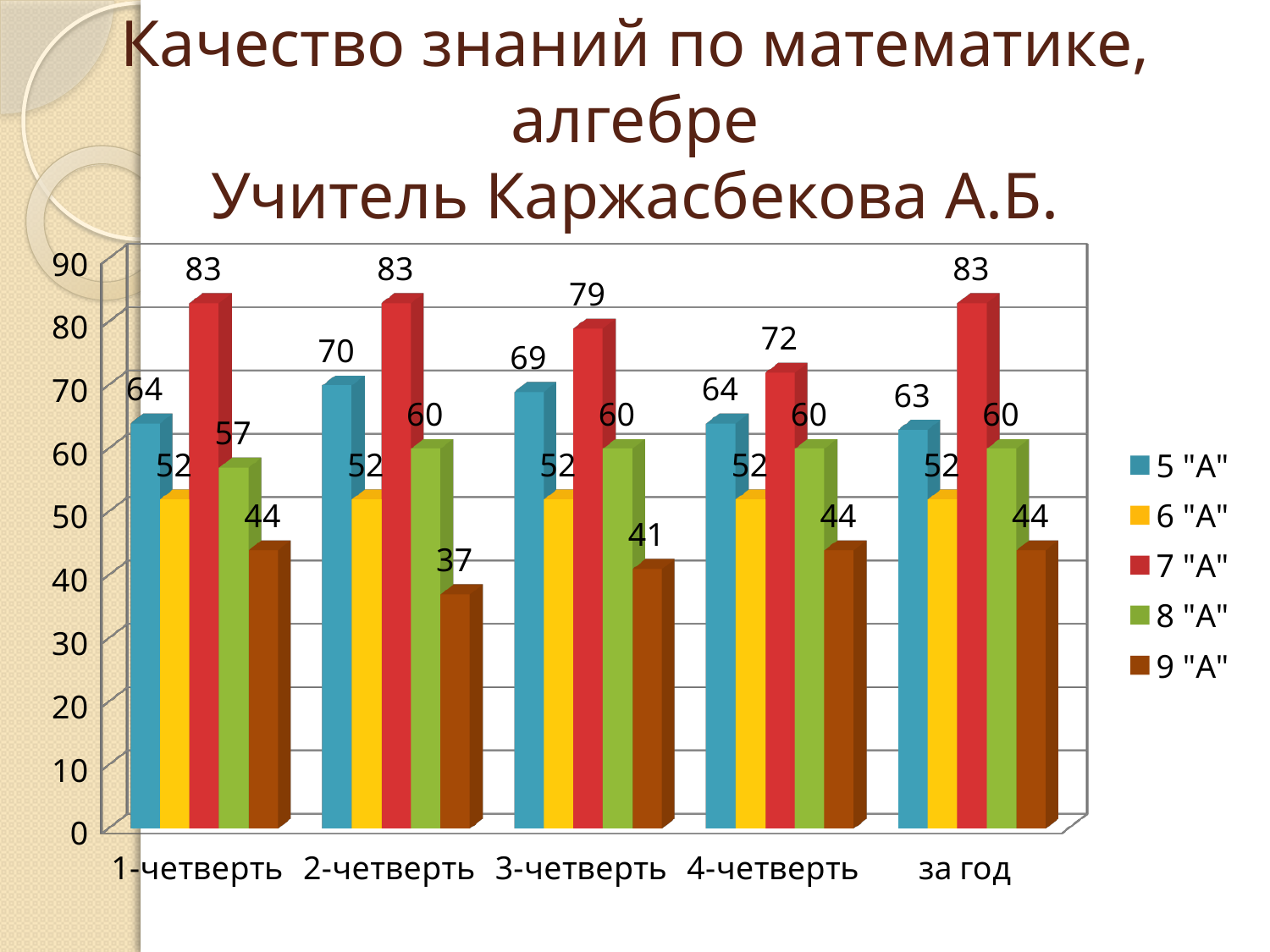
What is the value for 9 "А" in 2-четверть? 37 How many categories are shown on the x axis? 5 What is the value for 5 "А" in 2-четверть? 70 What is the value for 8 "А" in 1-четверть? 57 What kind of chart is shown on the slide? bar chart Which series has the lowest value in за год? 9 "А" Which series has the highest value in 4-четверть? 7 "А" Which is larger: the 5 "А" value in 3-четверть or the 5 "А" value in 4-четверть? 3-четверть How many series does the legend list? 5 What is the difference between the 7 "А" and 9 "А" values in 1-четверть? 39 Does the value for 6 "А" change across the categories from 1-четверть to за год? No, it stays at 52 What is the value for 7 "А" in 3-четверть? 79